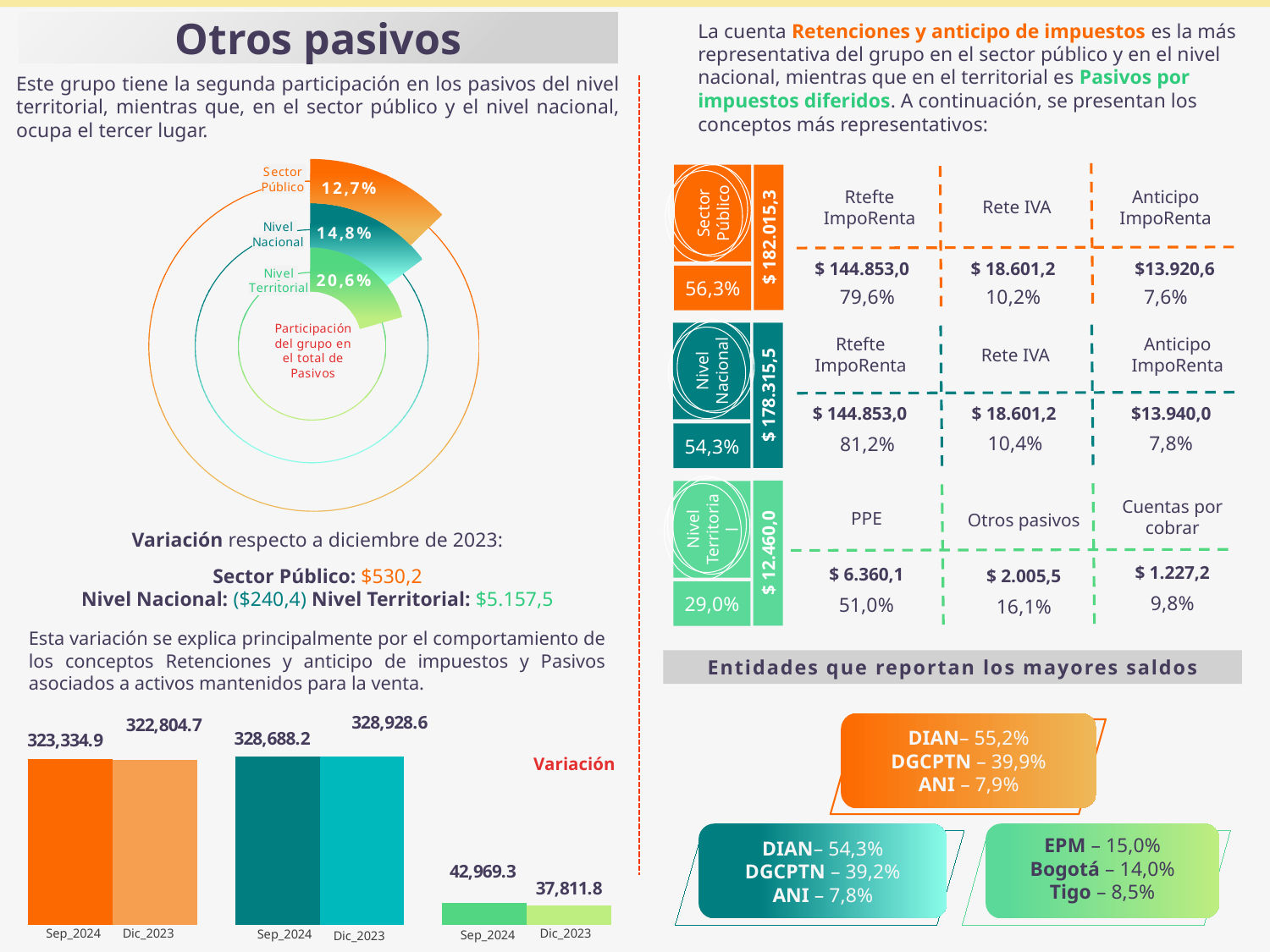
In the bar chart at the bottom left, what is the Sep_2024 value of the leftmost (orange) group? 323,334.9 In the radial chart 'Participación del grupo en el total de Pasivos', which category has the lowest value? Sector Público In the bar chart at the bottom left, which is larger for the middle (teal) group: the Sep_2024 value or the Dic_2023 value? Dic_2023 In the bar chart at the bottom left, what is the Dic_2023 value of the middle (teal) group? 328,928.6 In the radial chart 'Participación del grupo en el total de Pasivos', how many categories are shown? 3 In the radial chart 'Participación del grupo en el total de Pasivos', what is the value for Nivel Territorial? 20,6% In the radial chart 'Participación del grupo en el total de Pasivos', what is the value for Sector Público? 12,7% In the radial chart 'Participación del grupo en el total de Pasivos', which category has the highest value? Nivel Territorial In the bar chart at the bottom left, what is the difference between the Sep_2024 and Dic_2023 values of the leftmost (orange) group? 530.2 In the bar chart at the bottom left, what is the difference between the Sep_2024 and Dic_2023 values of the rightmost (green) group? 5,157.5 What kind of chart is shown at the bottom left of the slide? Bar chart In the bar chart at the bottom left, what is the Sep_2024 value of the rightmost (green) group? 42,969.3